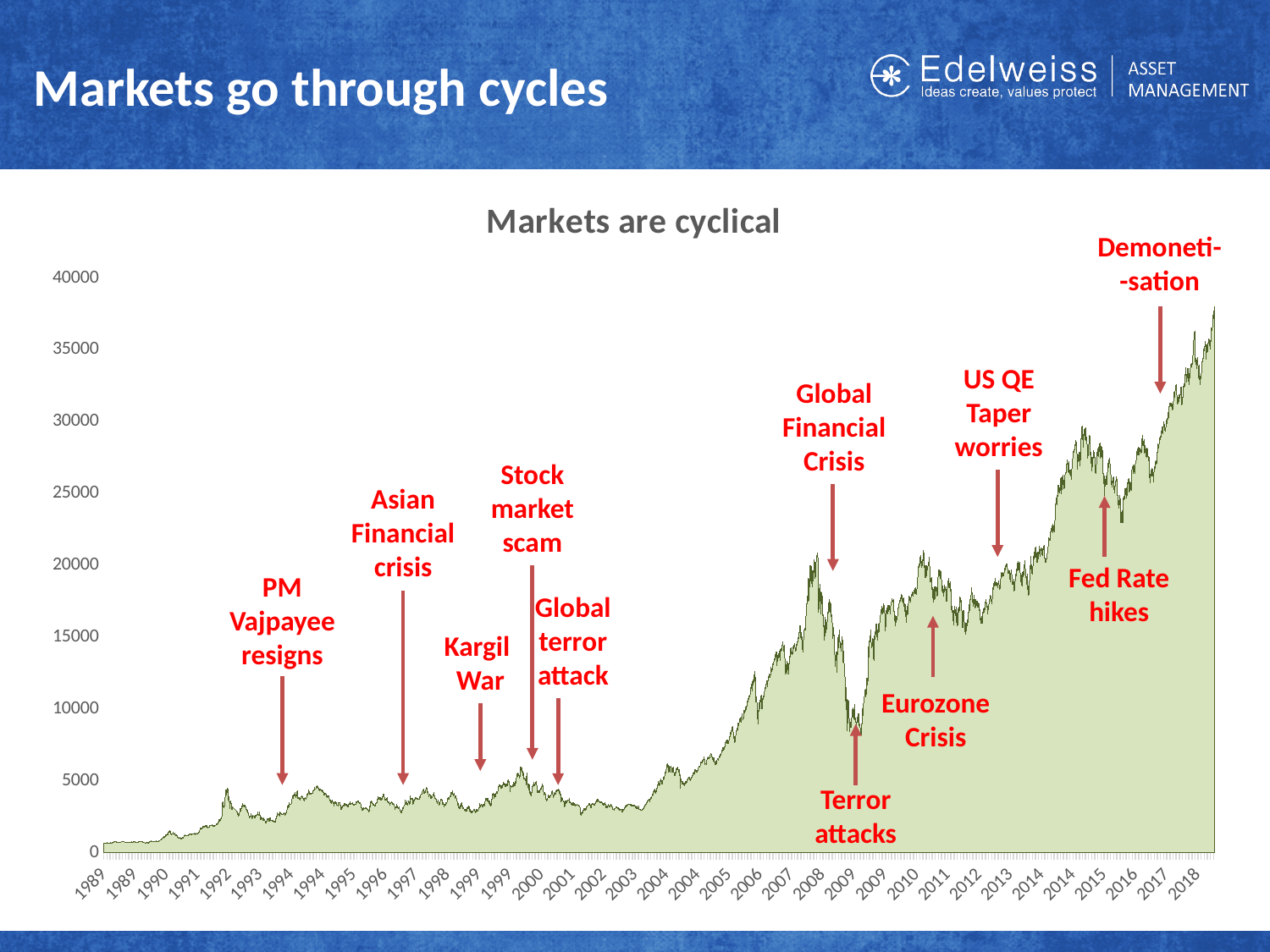
Overall, does the plotted value rise or fall from 1989 to 2018? Rise What is the title of the chart? Markets are cyclical What kind of chart is shown on the slide? Area chart Is the value at the 2008 peak (marked 'Global Financial Crisis') greater or less than 15000? greater Is the value at the start of the chart in 1989 greater or less than 5000? less How many events are annotated with arrows on the chart? 11 Which annotated event is marked at the far right of the chart, near the highest values? Demonetisation Which is larger: the value at the 2008 peak or the value at the 2009 low? The 2008 peak Does the value rise or fall between the 2008 peak and the 2009 low? Fall Is the value at the 2009 low point (marked 'Terror attacks') greater or less than 10000? less